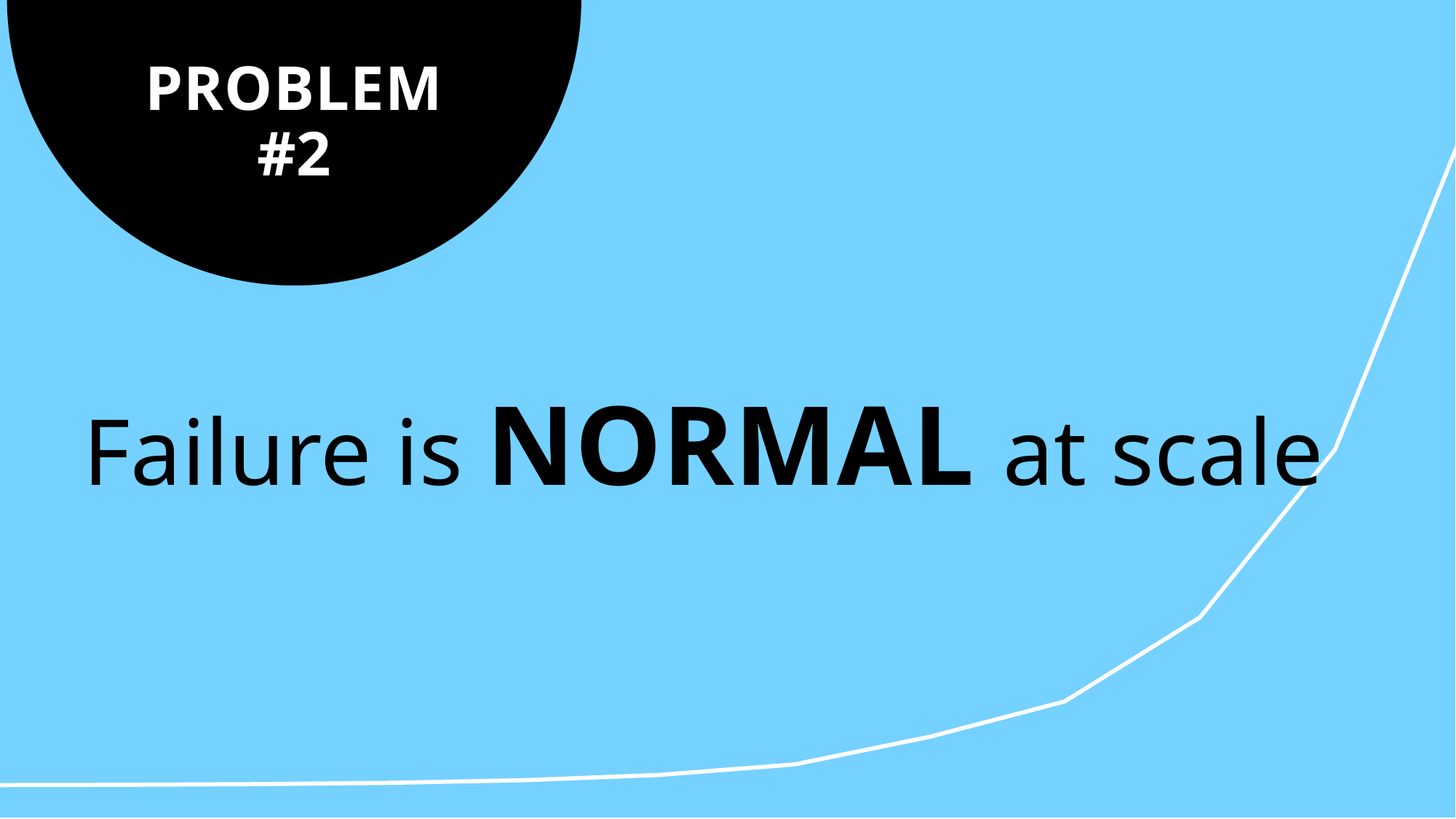
What kind of chart is drawn on the slide? line chart What colour is the plotted line? white Do the values of the line rise or fall from left to right? rise Is the line steeper on the left side or the right side of the slide? right side Does the chart show a legend? no